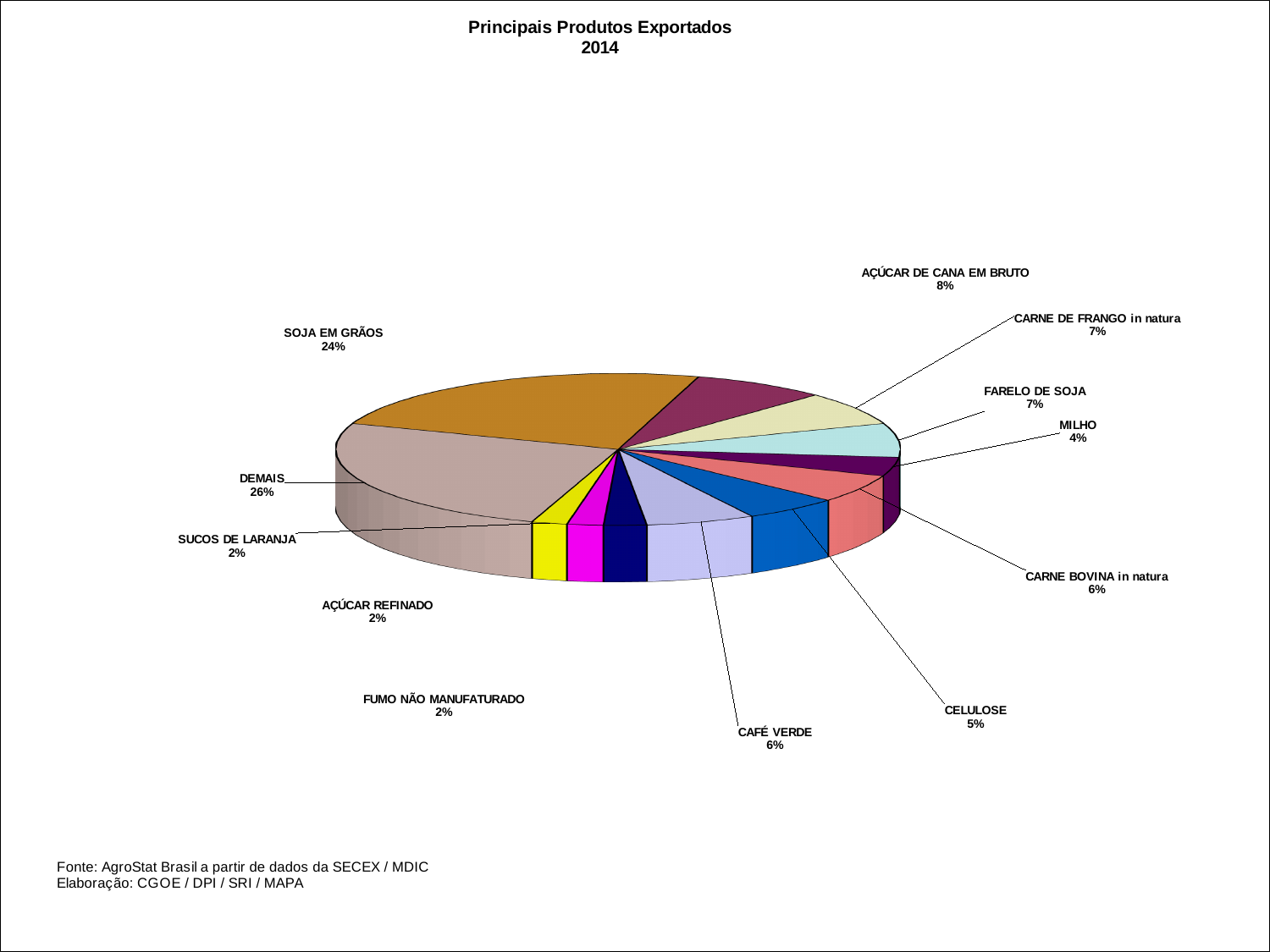
What percentage is shown for CELULOSE? 5% What percentage is shown for SUCOS DE LARANJA? 2% How many slices does the pie chart have? 12 What share of the pie does SOJA EM GRÃOS represent? 24% What is the combined share of FARELO DE SOJA and CARNE DE FRANGO in natura? 14% What percentage is shown for AÇÚCAR DE CANA EM BRUTO? 8% Which slice has the largest share of the pie? DEMAIS What is the title of the chart? Principais Produtos Exportados 2014 What kind of chart is shown on the slide? Pie chart Which has a larger share, CARNE BOVINA in natura or CARNE DE FRANGO in natura? CARNE DE FRANGO in natura What is the difference in percentage points between DEMAIS and SOJA EM GRÃOS? 2 What percentage is shown for MILHO? 4%